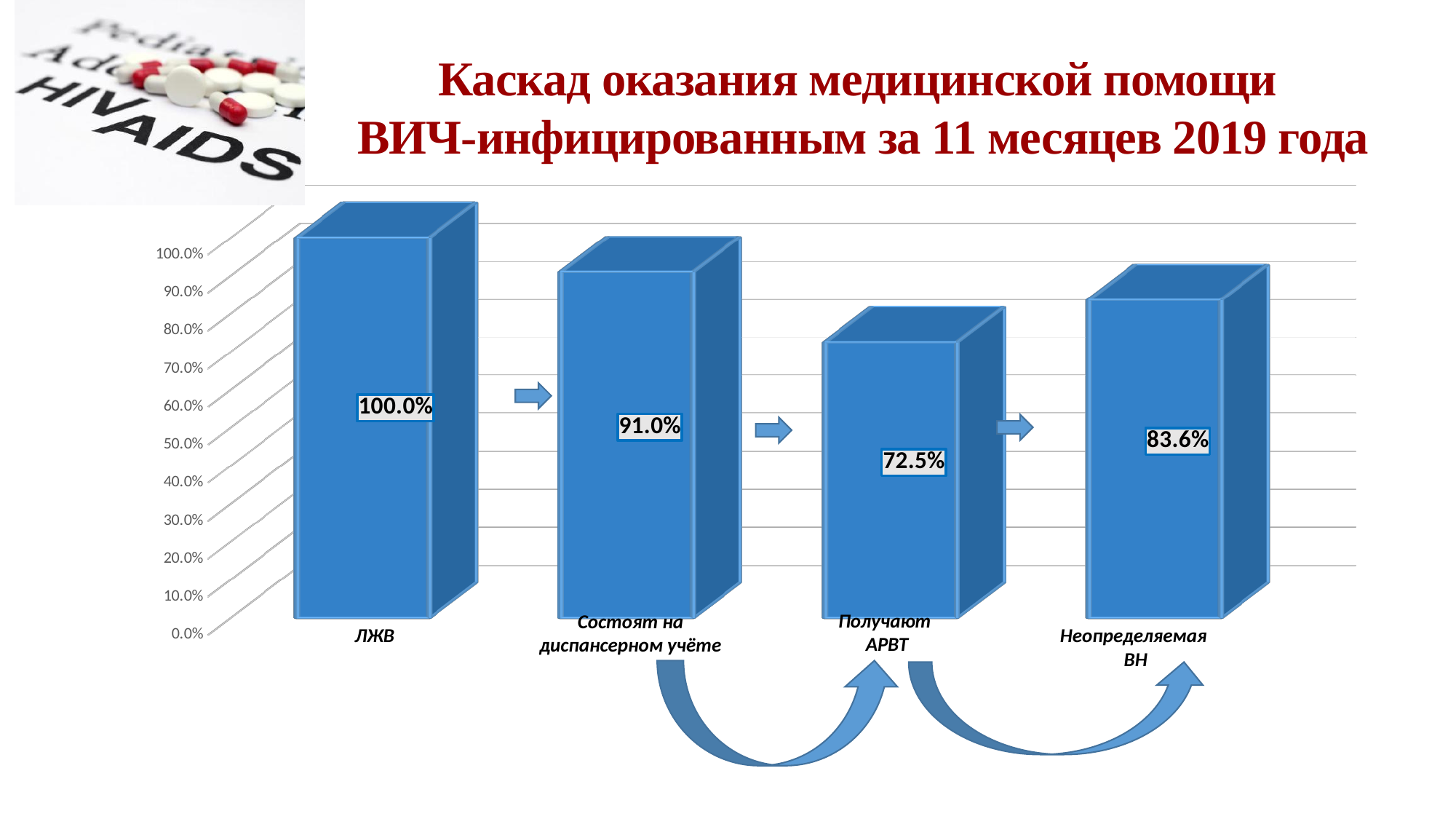
How many categories are shown in the chart? 4 What is the value for Неопределяемая ВН? 83.6% What is the value for Получают АРВТ? 72.5% What is the title of the slide? Каскад оказания медицинской помощи ВИЧ-инфицированным за 11 месяцев 2019 года Which category has the lowest value? Получают АРВТ What kind of chart is shown on the slide? bar chart What is the value for ЛЖВ? 100.0% Is the value for Получают АРВТ greater or less than 80.0%? less What is the difference between the values for Состоят на диспансерном учёте and Получают АРВТ? 18.5% What is the value for Состоят на диспансерном учёте? 91.0% Which category has the highest value? ЛЖВ Which is larger, the value for Неопределяемая ВН or the value for Получают АРВТ? Неопределяемая ВН